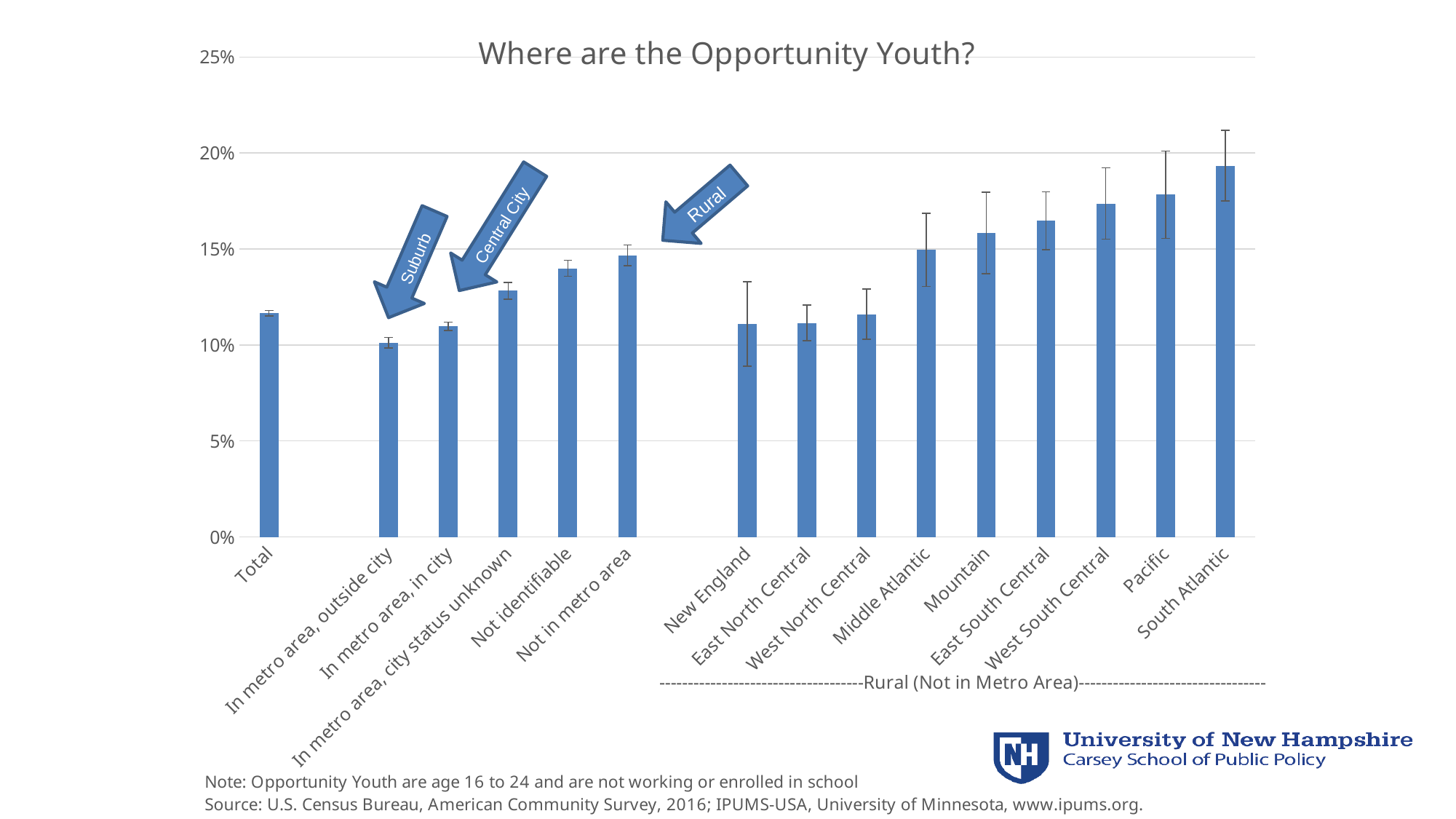
Is the value for South Atlantic greater or less than 20%? less Is the value for Not in metro area greater or less than 15%? less What kind of chart is shown on the slide? bar chart Which category has the lowest value in the chart? In metro area, outside city What is the title of the chart? Where are the Opportunity Youth? Which is larger, the value for Pacific or the value for Mountain? Pacific How many bars are plotted in the chart? 15 Is the value for Total greater or less than 10%? greater Which category has the highest value in the chart? South Atlantic Which is larger, the value for Not identifiable or the value for In metro area, in city? Not identifiable Which arrow label points to the bar for In metro area, outside city? Suburb